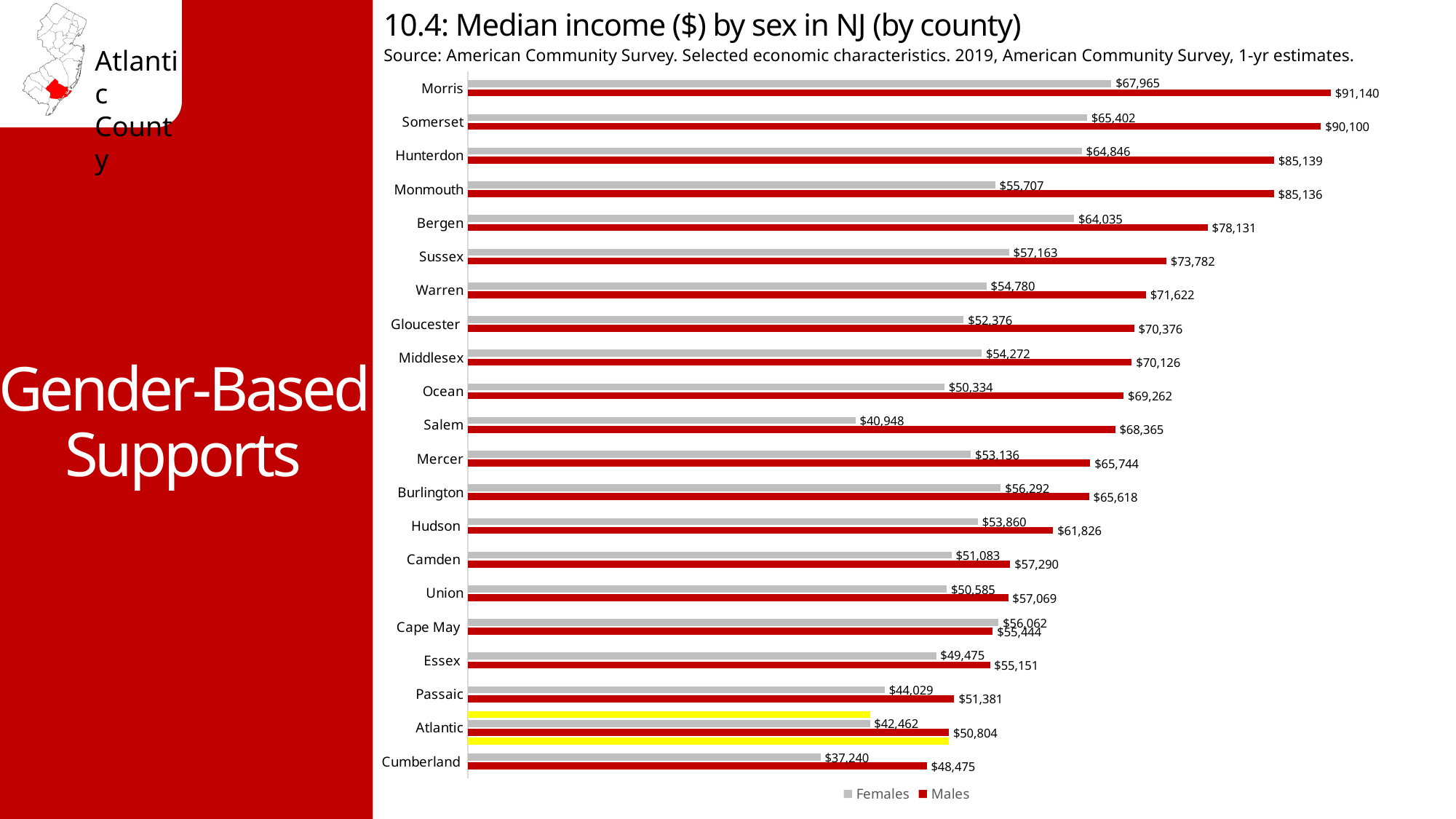
What type of chart is shown on the slide? Bar chart What is the median income for males in Atlantic County? $50,804 Which county has the highest median income for males? Morris In Cape May County, which is higher: the median income for females or for males? Females What is the median income for females in Salem County? $40,948 What is the median income for females in Atlantic County? $42,462 What is the difference between male and female median income in Atlantic County? $8,342 What colour represents the Males series in the chart? Red How many series does the legend list? 2 How many counties are shown in the chart? 21 Which county has the lowest median income for females? Cumberland What is the difference between male and female median income in Morris County? $23,175